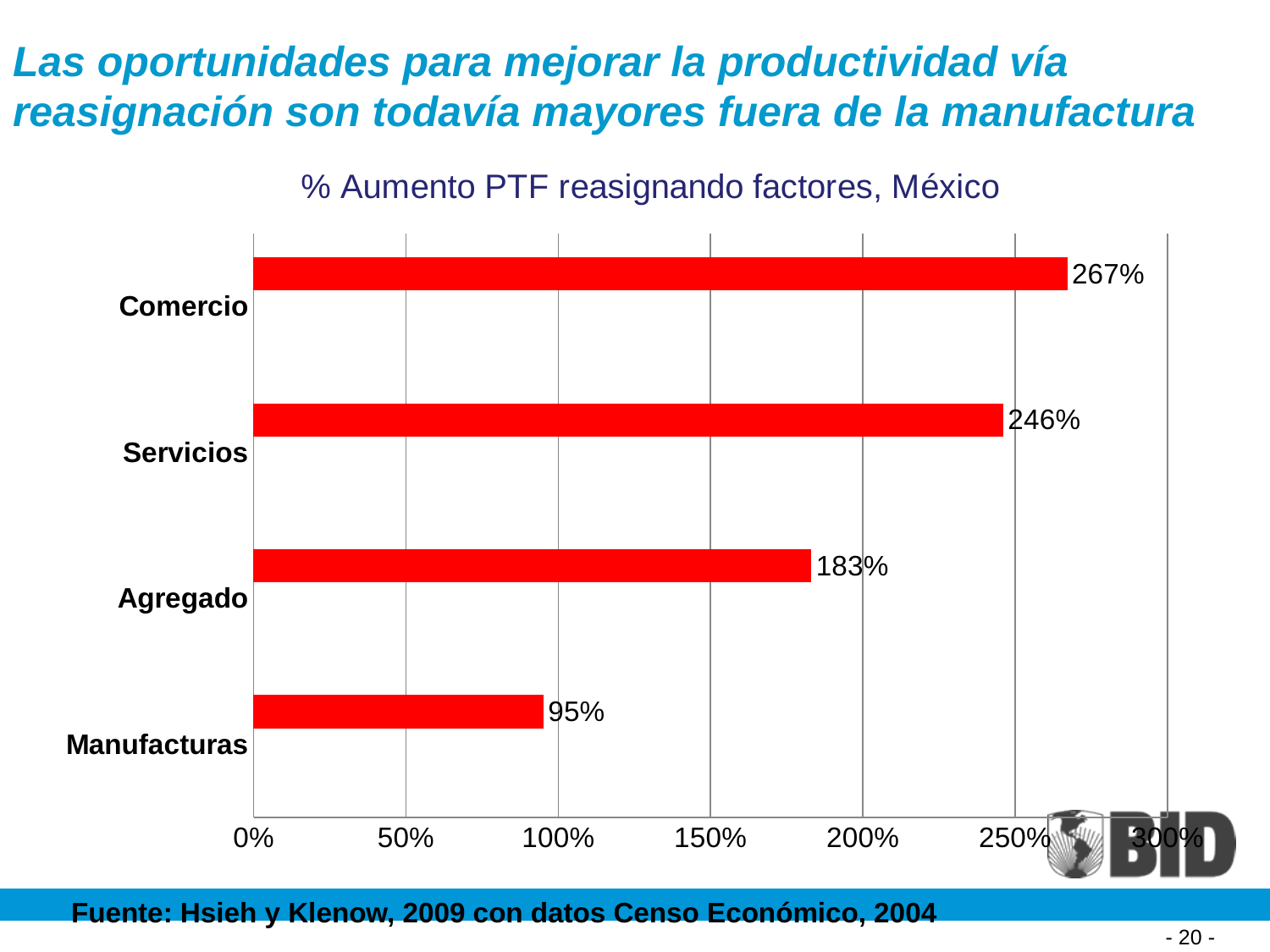
What is the value for Agregado? 183% What is the difference between the values for Comercio and Manufacturas? 172% What kind of chart is shown on the slide? Bar chart What is the title of the chart? % Aumento PTF reasignando factores, México Which category has the highest value? Comercio Which is larger, the value for Agregado or the value for Manufacturas? Agregado What is the value for Manufacturas? 95% What is the value for Servicios? 246% What is the difference between the values for Servicios and Agregado? 63% What is the value for Comercio? 267% How many categories are shown in the chart? 4 Which category has the lowest value? Manufacturas